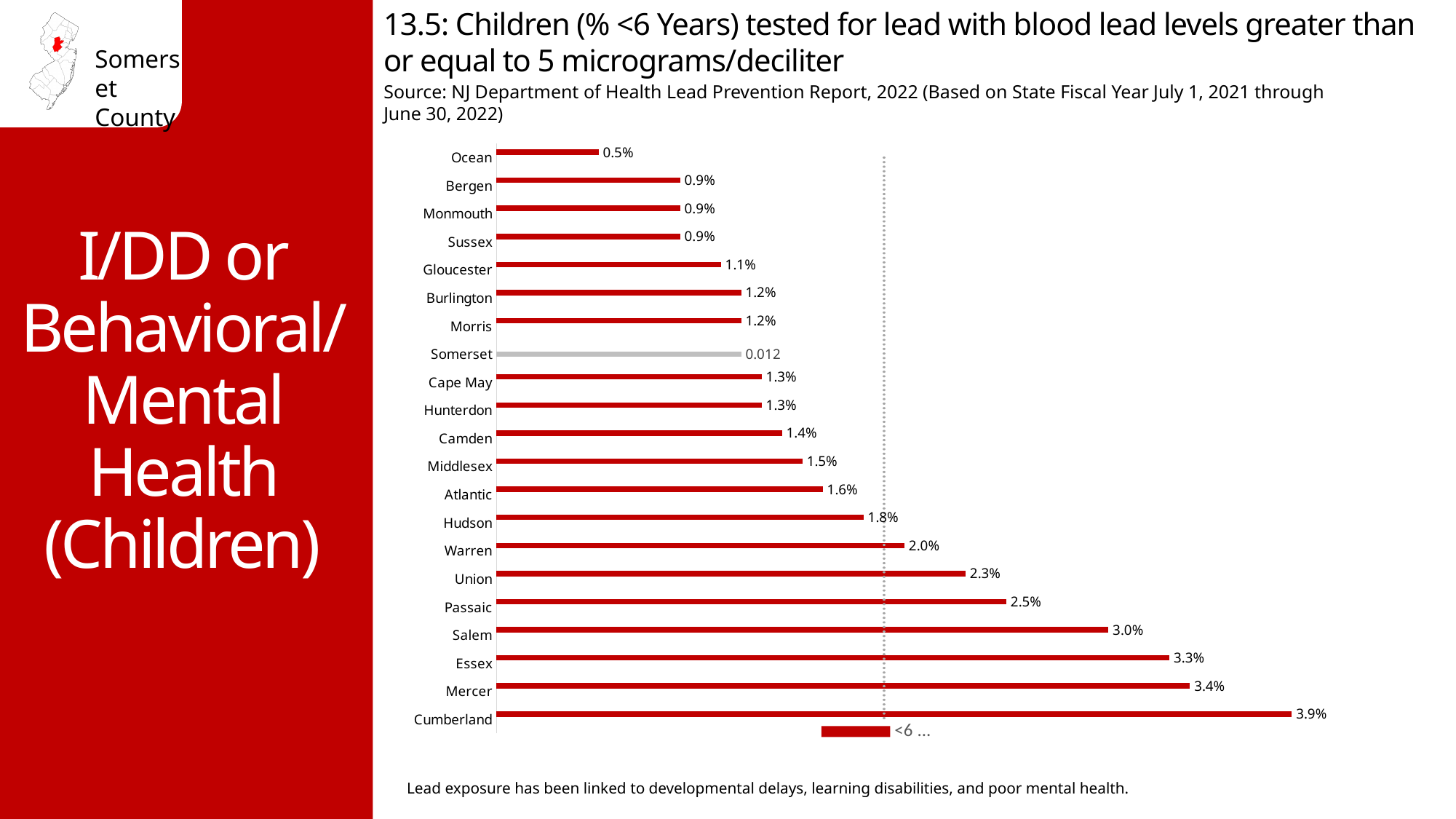
What is the value for Hudson? 1.8% Which county has the lowest value? Ocean Which county's bar is shown in gray rather than red? Somerset Which has a larger value, Salem or Passaic? Salem What kind of chart is shown on the slide? Bar chart What is the difference between the values for Mercer and Essex? 0.1% What is the value for Ocean? 0.5% How many counties are shown in the chart? 21 Which county has the highest value? Cumberland What is the value for Cumberland? 3.9% What is the difference between the values for Cumberland and Ocean? 3.4% What value is shown for Somerset? 0.012